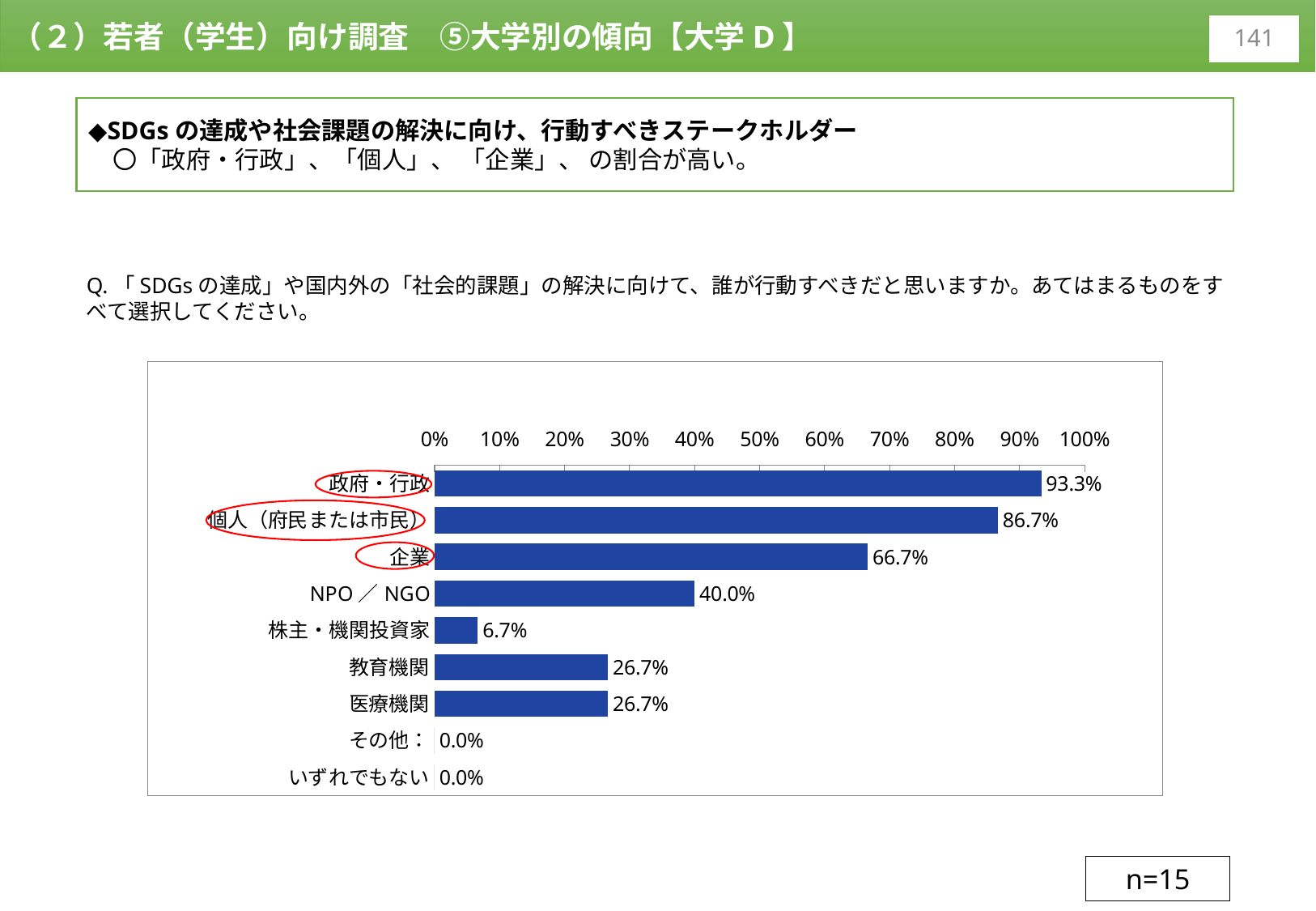
Which is larger, the value for 企業 or the value for NPO／NGO? 企業 Is the value for 個人（府民または市民） greater or less than 80%? greater How many categories are shown in the chart? 9 Which category has the lowest non-zero value? 株主・機関投資家 What is the value for 個人（府民または市民）? 86.7% What is the value for 株主・機関投資家? 6.7% How many categories have a value of 0.0%? 2 What kind of chart is shown on the slide? bar chart Which category has the highest value? 政府・行政 What is the value for NPO／NGO? 40.0% What is the value for 政府・行政? 93.3% What is the difference between the values for 政府・行政 and 企業? 26.6%